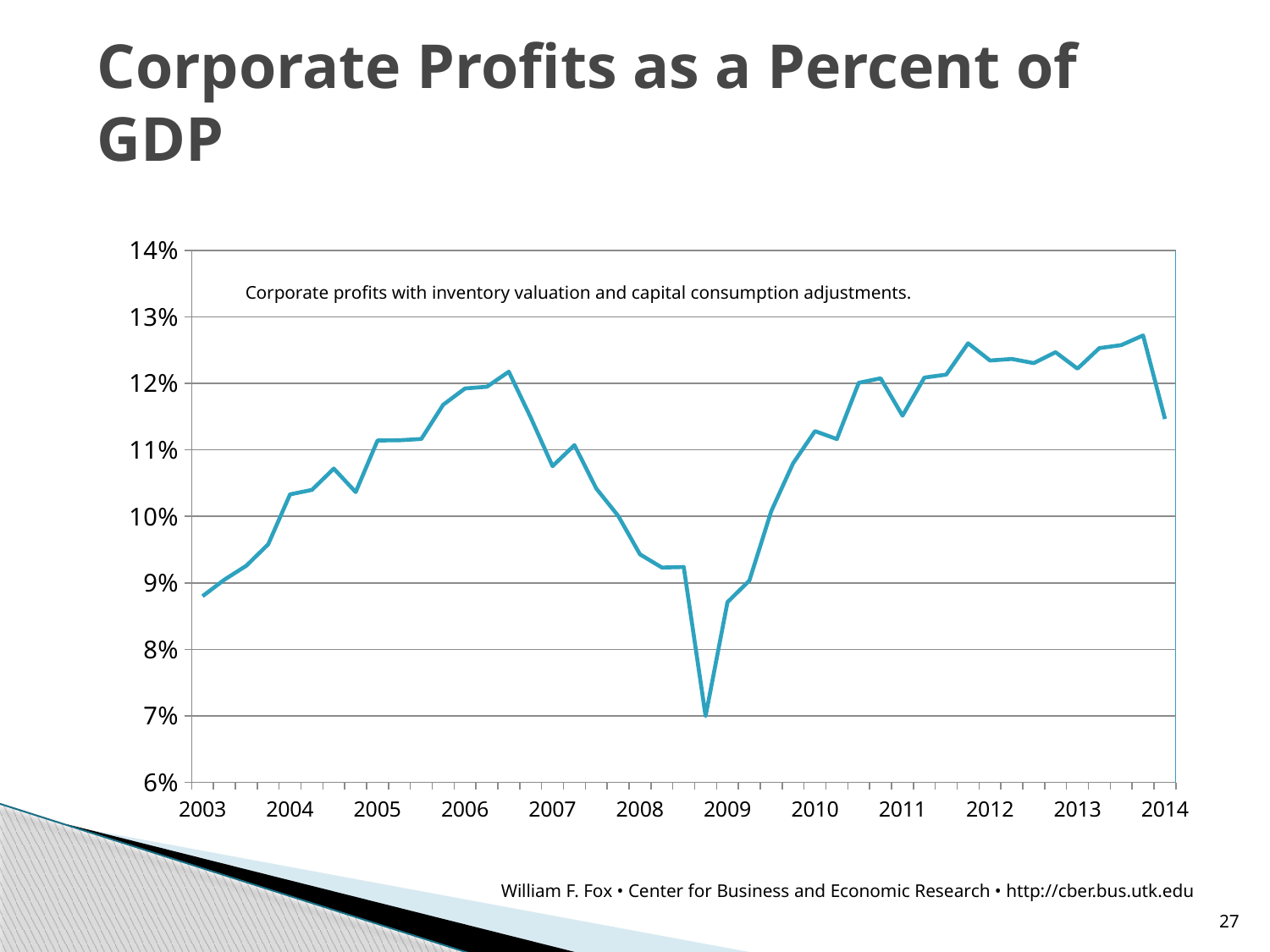
Is the value at 2014 greater or less than 11%? greater Does the line rise or fall from 2003 to 2006? rise What note is printed inside the plot area of the chart? Corporate profits with inventory valuation and capital consumption adjustments. Is the lowest point of the line, between 2008 and 2009, greater or less than 8%? less Which is larger, the value at 2003 or the value at 2014? 2014 What is the title of the chart? Corporate Profits as a Percent of GDP Is the value at 2010 greater or less than 10%? greater What kind of chart is shown on the slide? line chart Between which two year labels does the line reach its lowest point? 2008 and 2009 Does the line rise or fall from 2007 to the end of 2008? fall